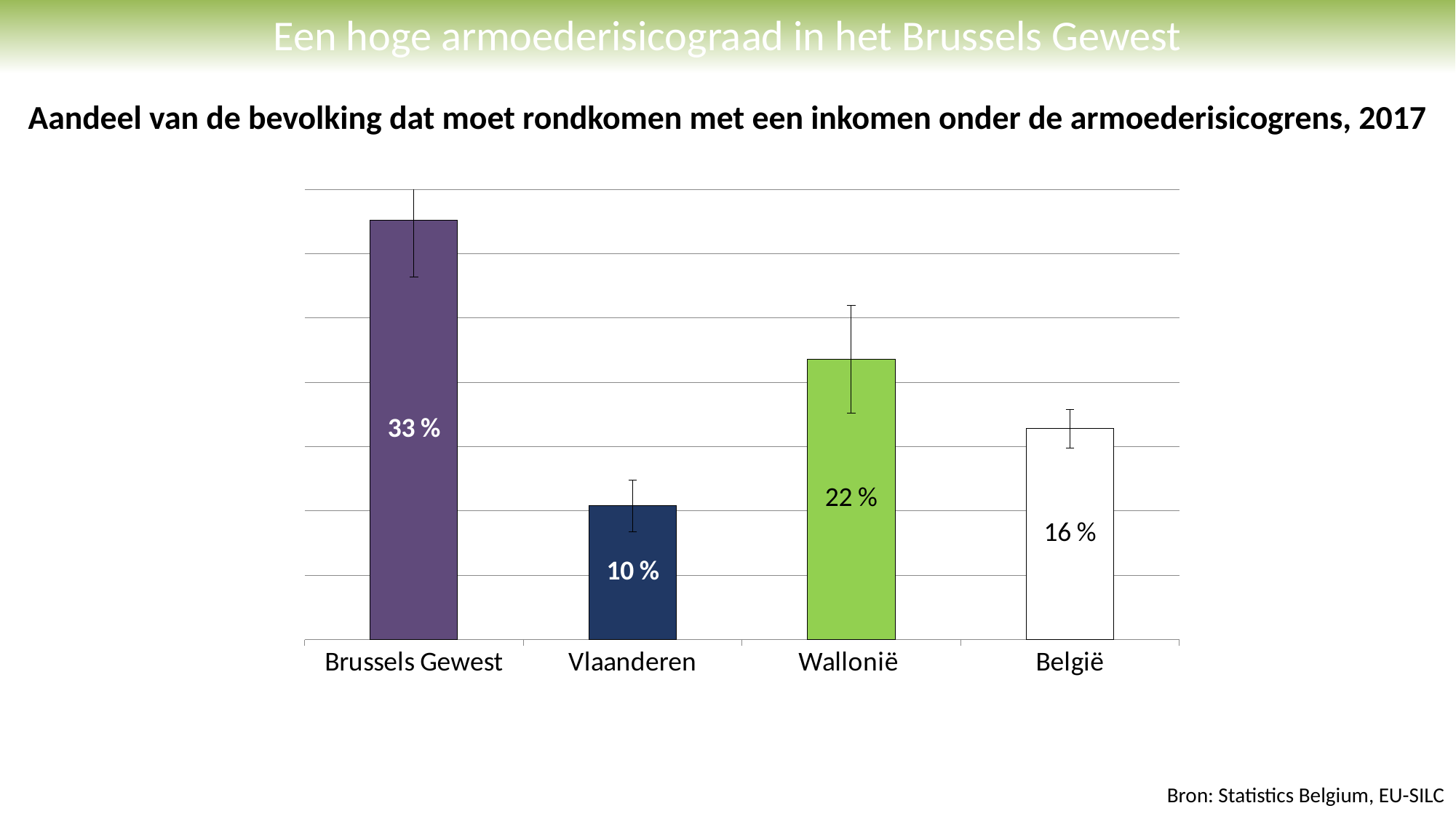
What is the difference between the values for Wallonië and België? 6 % What is the value for Vlaanderen? 10 % What is the value for Brussels Gewest? 33 % What colour is the bar for Wallonië? green What kind of chart is shown on the slide? bar chart What is the difference between the values for Brussels Gewest and Vlaanderen? 23 % Which category has the highest value? Brussels Gewest Which is larger, the value for Wallonië or the value for België? Wallonië What is the value for België? 16 % What is the value for Wallonië? 22 % Which category has the lowest value? Vlaanderen How many categories are shown on the x axis? 4